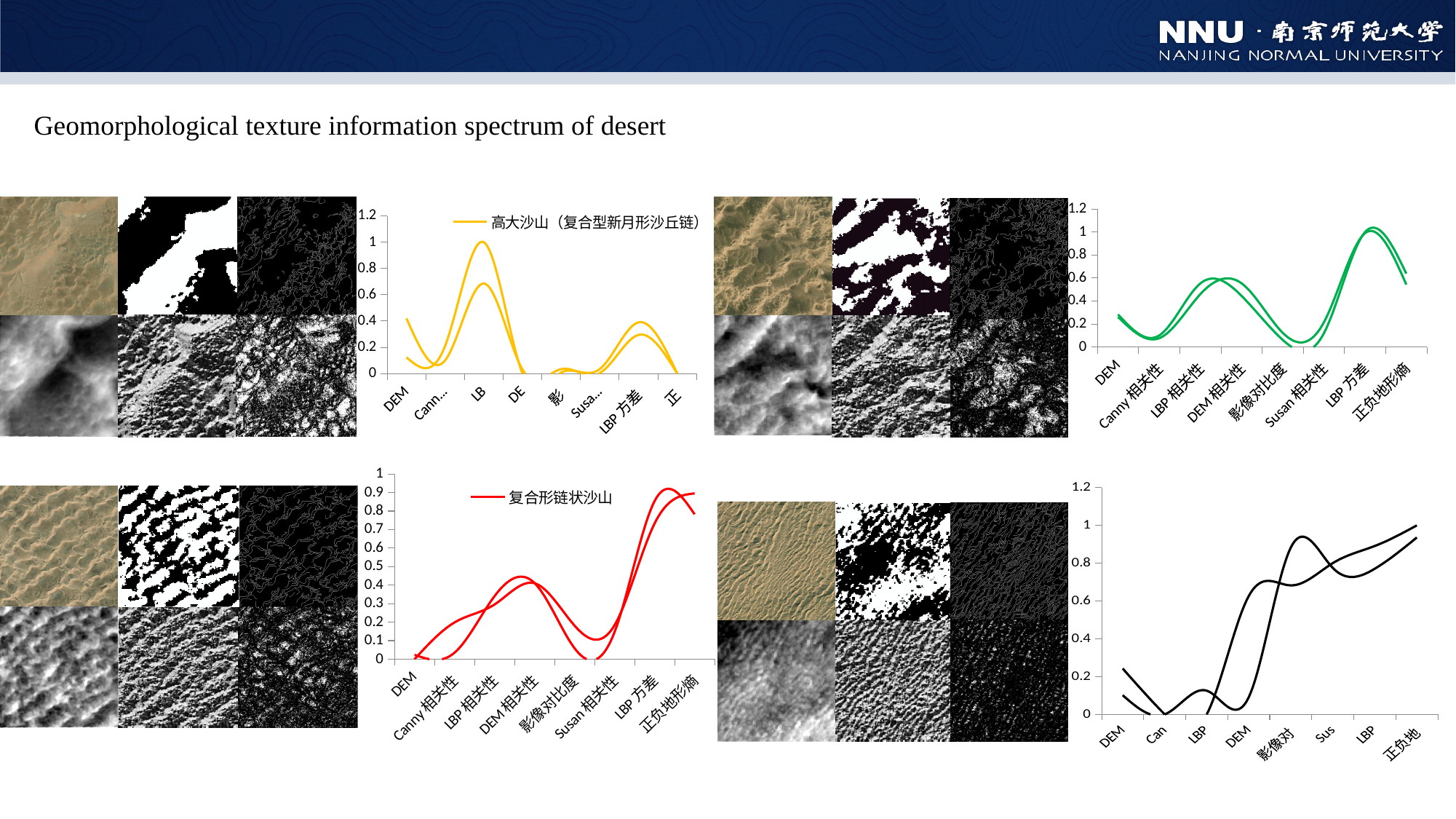
In the top-left chart, which x-axis category has the highest value? LB In the top-right chart, how many categories are on the x axis? 8 In the bottom-right chart with the black lines, which x-axis category has the highest value? 正负地 In the top-left chart, what does the legend entry say? 高大沙山（复合型新月形沙丘链） What kind of chart is the top-left chart with the yellow lines? line chart In the top-left chart, which is larger, the value at LB or the value at DE? LB In the bottom-left chart, what does the legend entry say? 复合形链状沙山 In the bottom-left chart, which x-axis category has the highest value? 正负地形熵 In the top-left chart, is the value at LB greater or less than 0.6? greater In the top-right chart, is the value at DEM greater or less than 0.4? less